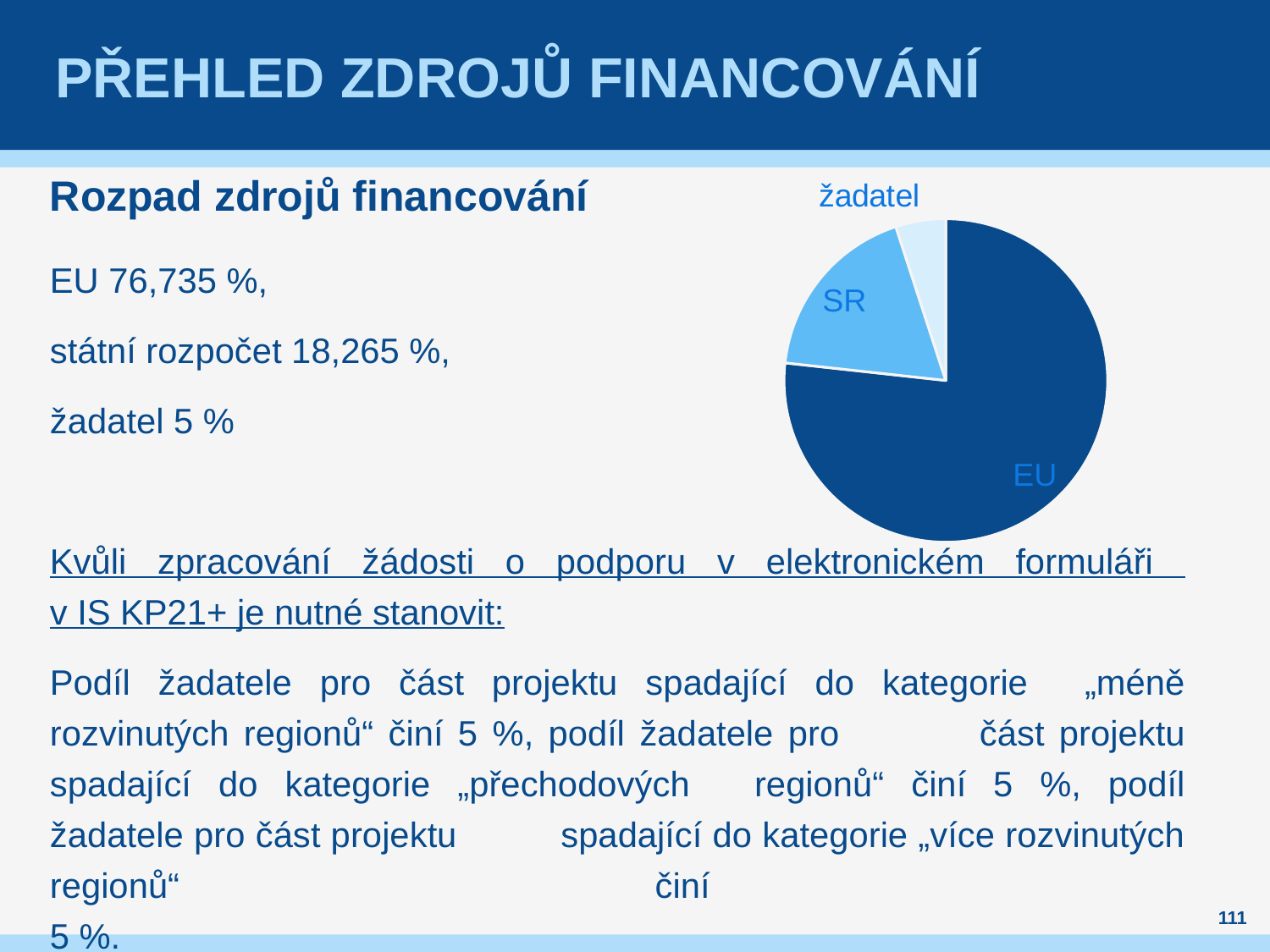
Which slice is larger in the pie chart, SR or žadatel? SR According to the slide, what share of the funding does the žadatel slice represent? 5 % How many slices does the pie chart have? 3 What colour is the EU slice in the pie chart? dark blue What are the labels of the three slices in the pie chart? EU, SR, žadatel Which slice is larger in the pie chart, EU or SR? EU Which slice of the pie chart is the smallest? žadatel According to the slide, what share of the funding does the SR (státní rozpočet) slice represent? 18,265 % Is the EU slice of the pie chart greater or less than half of the pie? greater Which slice of the pie chart is the largest? EU According to the slide, what share of the funding does the EU slice represent? 76,735 % What kind of chart is shown on the slide? pie chart